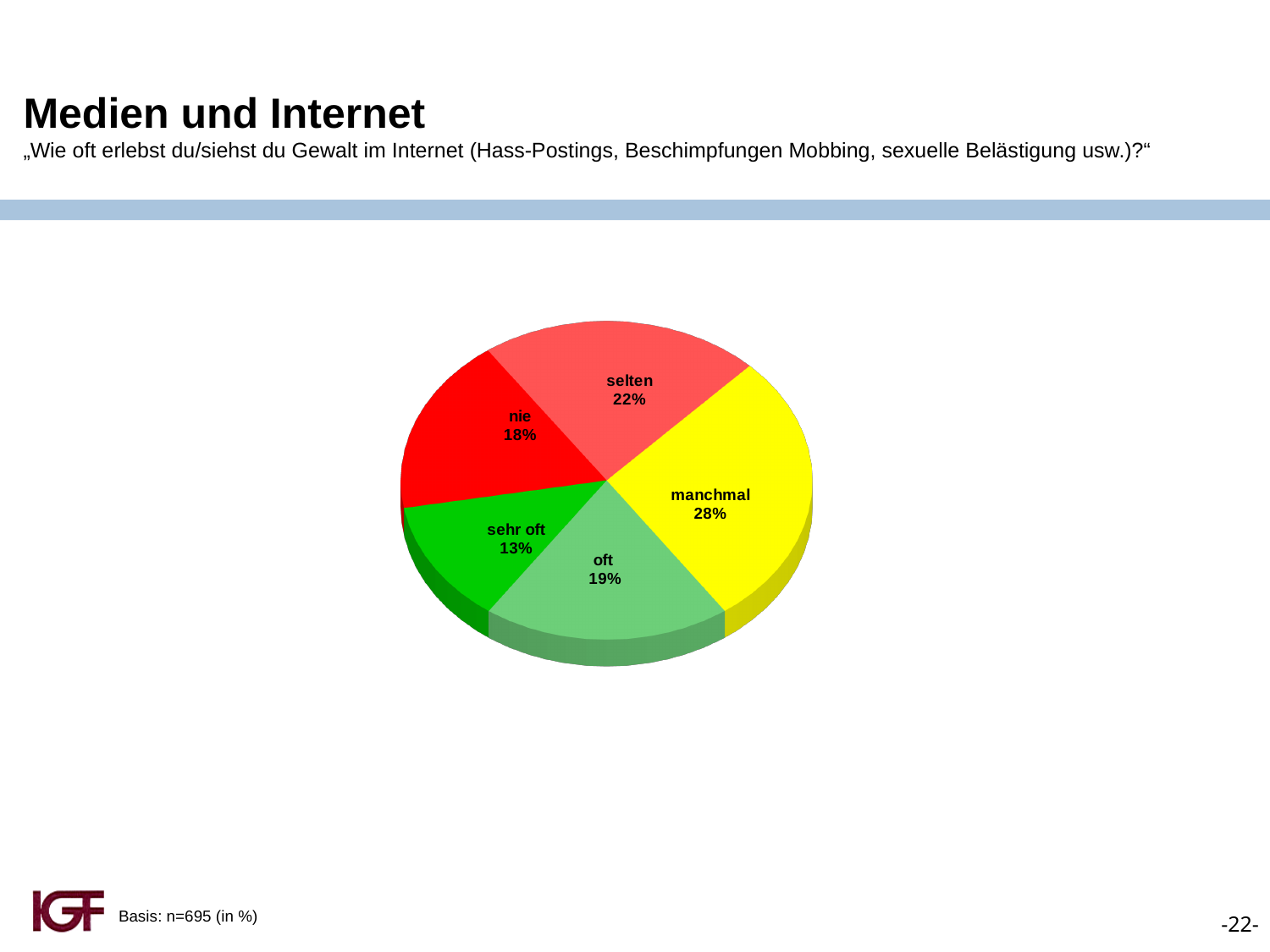
What colour is the "manchmal" slice? yellow What is the sample size (Basis) stated on the slide? n=695 What percentage is shown for "manchmal"? 28% How many slices does the pie chart have? 5 Which category has the largest share of the pie? manchmal What kind of chart is shown on the slide? pie chart What is the difference in percentage points between "manchmal" and "selten"? 6 What percentage is shown for "oft"? 19% Which is larger, the share for "selten" or the share for "nie"? selten What percentage is shown for "nie"? 18% What percentage is shown for "sehr oft"? 13% Which category has the smallest share of the pie? sehr oft